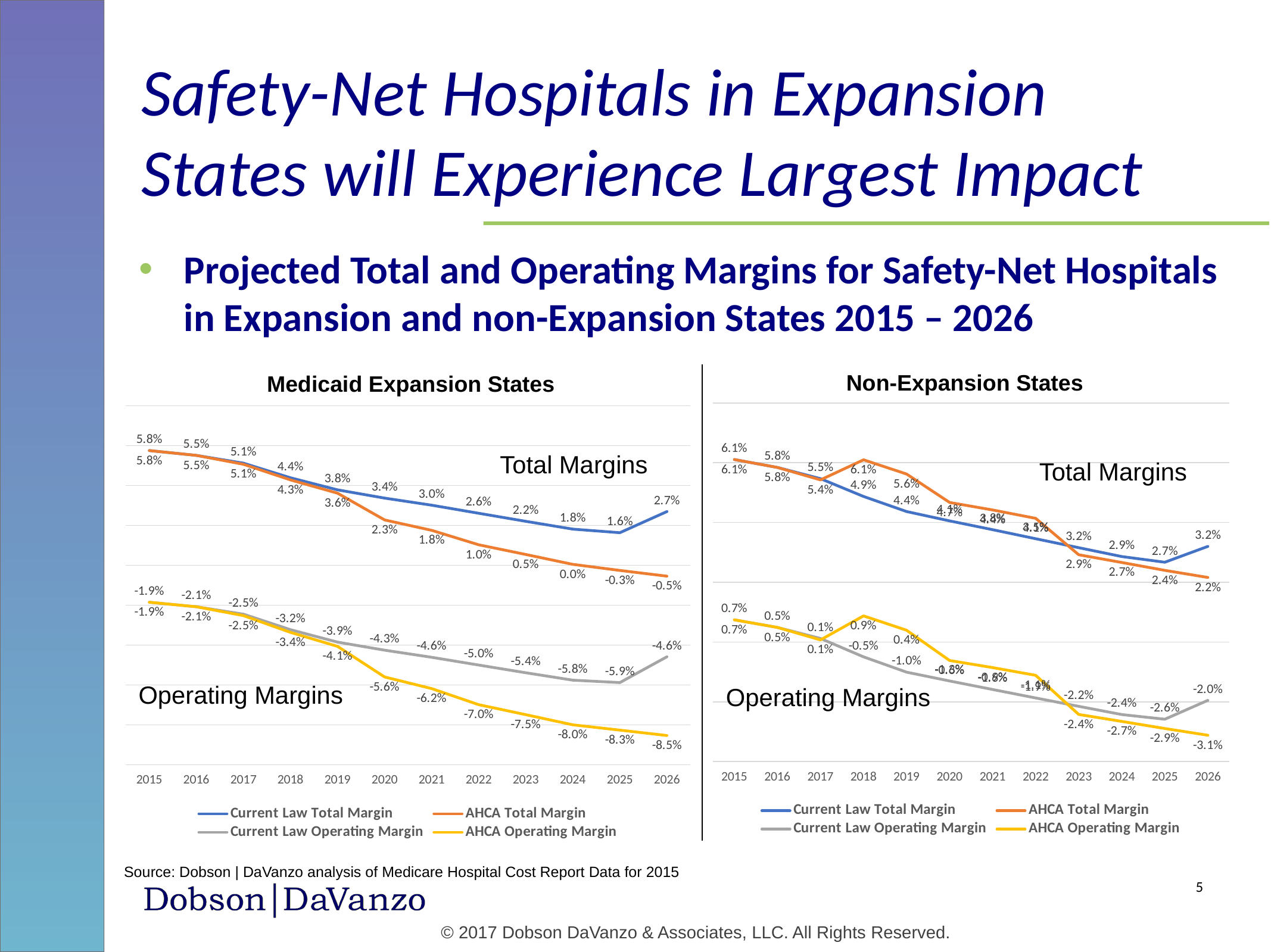
In the Medicaid Expansion States chart, what is the difference between the Current Law Total Margin and the AHCA Total Margin in 2026? 3.2% In the Medicaid Expansion States chart, which is larger in 2024: the Current Law Operating Margin or the AHCA Operating Margin? Current Law Operating Margin In the Medicaid Expansion States chart, what is the Current Law Total Margin in 2025? 1.6% How many series does the legend of the Non-Expansion States chart list? 4 In the Medicaid Expansion States chart, which year has the lowest AHCA Operating Margin? 2026 In the Non-Expansion States chart, what is the AHCA Total Margin in 2018? 6.1% In the Medicaid Expansion States chart, what is the AHCA Operating Margin in 2026? -8.5% In the Non-Expansion States chart, what is the Current Law Operating Margin in 2026? -2.0% In the Non-Expansion States chart, which year has the highest AHCA Operating Margin? 2018 In the Non-Expansion States chart, what is the difference between the AHCA Operating Margin and the Current Law Operating Margin in 2025? 0.3% What kind of chart is the Medicaid Expansion States chart? Line chart How many years are shown on the x axis of the Medicaid Expansion States chart? 12